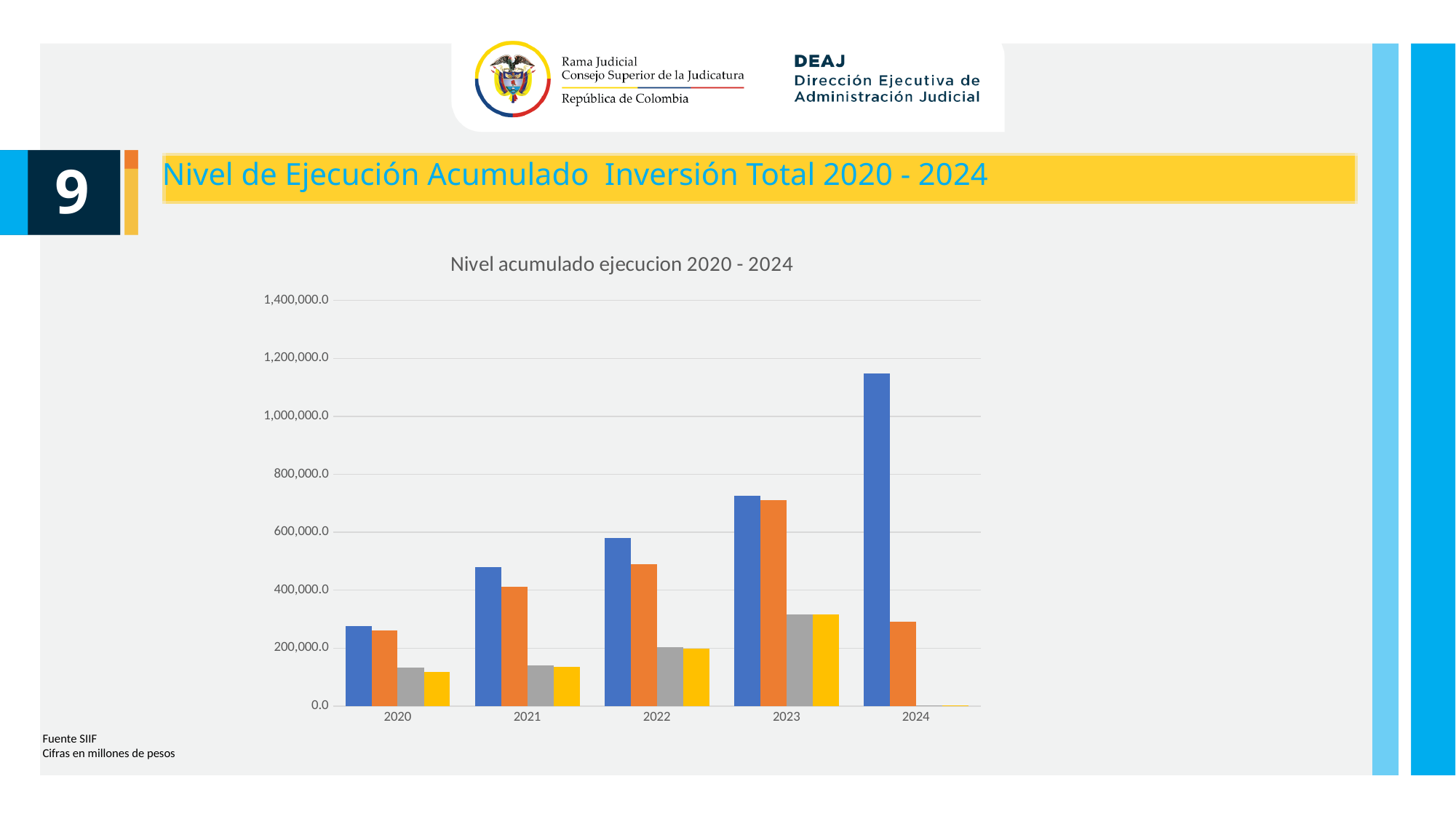
What is the title of the chart? Nivel acumulado ejecucion 2020 - 2024 How many years are shown along the x axis of the chart? 5 Which year has the tallest bar in the chart? 2024 Is the value of the orange bar for 2023 greater or less than 600,000.0? greater Is the value of the orange bar for 2024 greater or less than 400,000.0? less How many different bar colours appear in the 2023 group? 4 Is the value of the blue bar for 2024 greater or less than 1,000,000.0? greater What source is cited below the chart? Fuente SIIF Which is larger, the blue bar for 2023 or the blue bar for 2022? 2023 What kind of chart is shown on the slide? bar chart Do the blue bars rise or fall from 2020 to 2024? rise